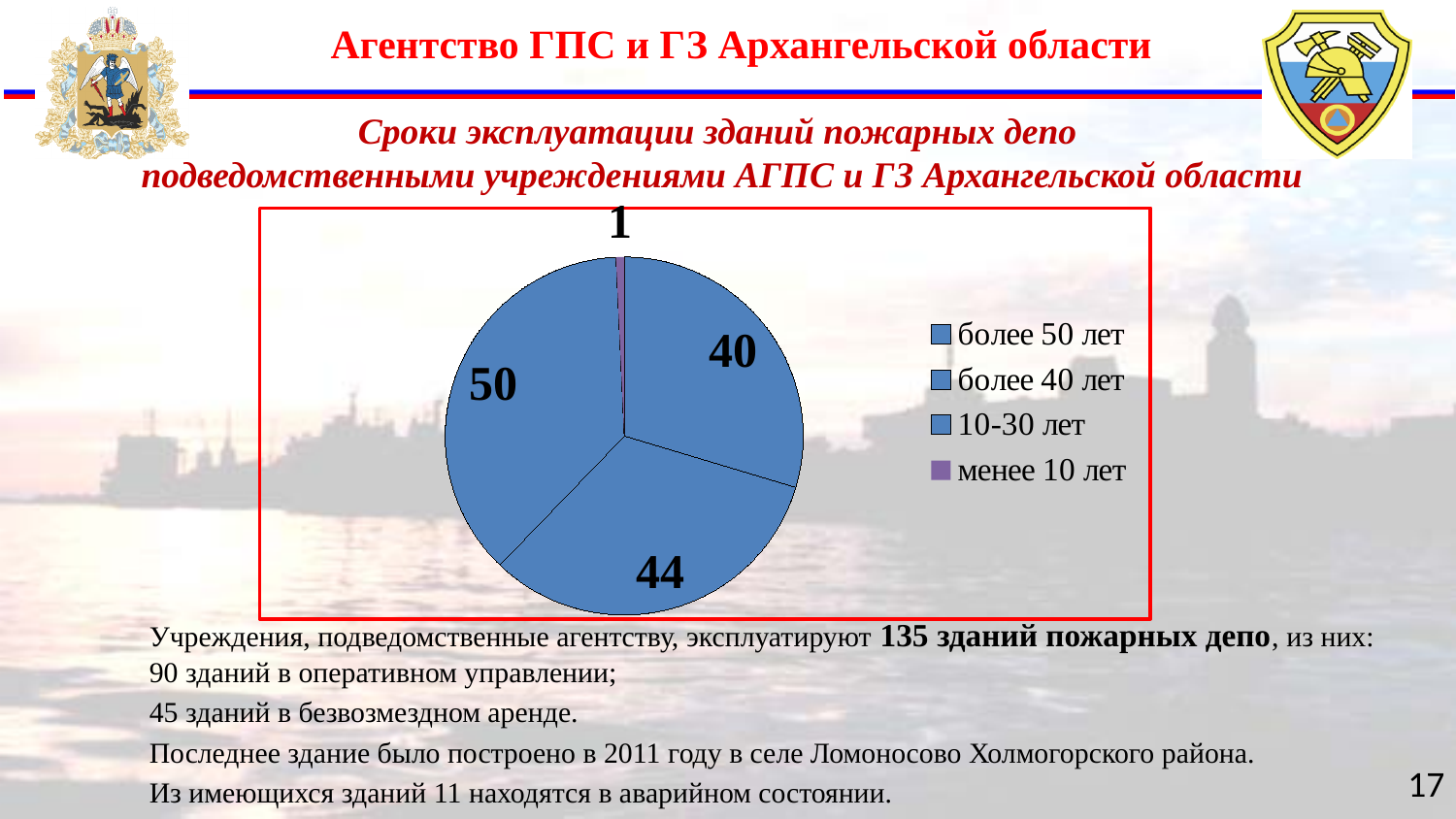
What is the largest value labelled on the pie chart? 50 What is the title of the chart on the slide? Сроки эксплуатации зданий пожарных депо подведомственными учреждениями АГПС и ГЗ Архангельской области Which legend entry of the pie chart is shown in purple? менее 10 лет How many categories does the legend of the pie chart list? 4 How many slices does the pie chart have? 4 What is the difference between the slice labelled 50 and the slice labelled 44? 6 What type of chart is shown on the slide? pie chart Which is larger: the slice labelled 44 or the slice labelled 40? 44 What is the total of all the values labelled on the pie chart? 135 What is the difference between the slice labelled 44 and the slice labelled 40? 4 What is the value of the slice for 'менее 10 лет' in the pie chart? 1 What is the smallest value labelled on the pie chart? 1